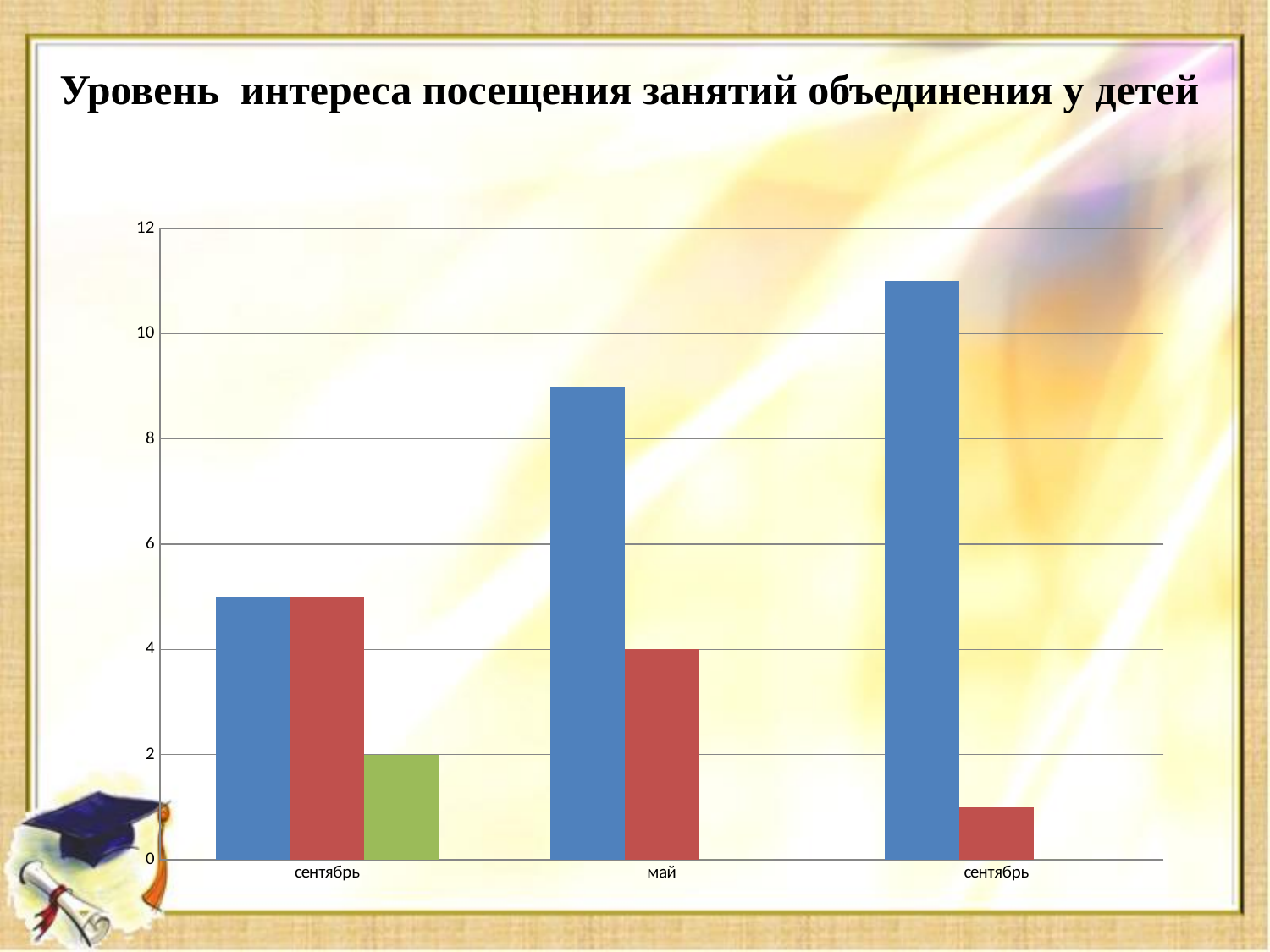
Is the value of the blue bar for май greater or less than 8? greater What kind of chart is shown on the slide? bar chart Is the value of the red bar in the rightmost сентябрь category greater or less than 2? less How many categories are shown on the x axis of the chart? 3 Is the value of the blue bar in the rightmost сентябрь category greater or less than 10? greater Which category has the shortest red bar? the rightmost сентябрь Which category has the tallest blue bar? the rightmost сентябрь Do the blue bars rise or fall from left to right across the categories? rise What is the value of the green bar in the first сентябрь category? 2 What is the value of the red bar for май? 4 Which is larger: the blue bar for май or the blue bar in the rightmost сентябрь category? the blue bar in the rightmost сентябрь category